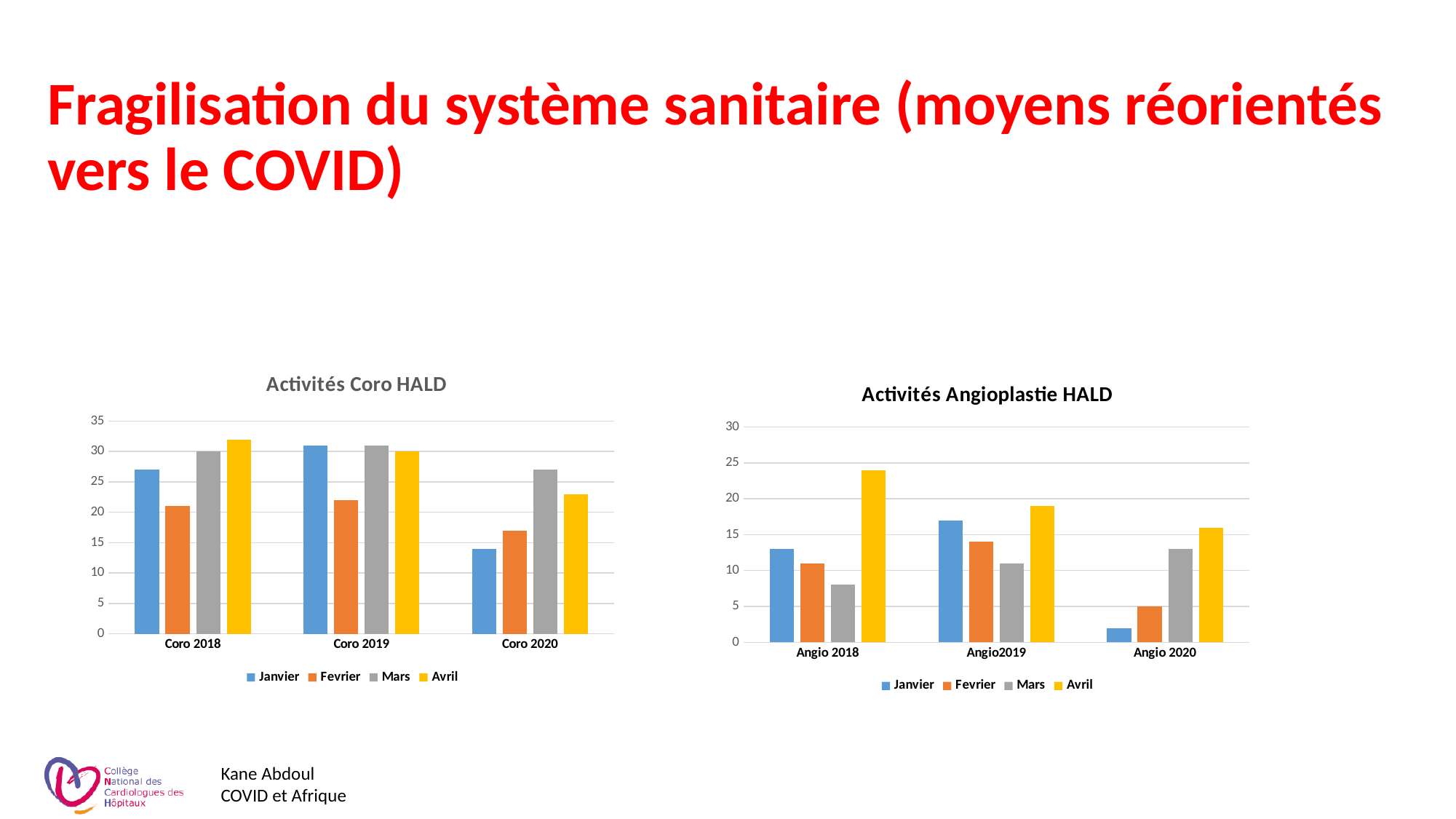
In 'Activités Coro HALD', what is the value for Avril in Coro 2019? 30 In 'Activités Angioplastie HALD', which bar is the highest in the whole chart? Avril, Angio 2018 In 'Activités Angioplastie HALD', which bar is the lowest in the whole chart? Janvier, Angio 2020 In 'Activités Angioplastie HALD', what is the value for Fevrier in Angio 2020? 5 What type of chart is 'Activités Coro HALD'? bar chart In 'Activités Coro HALD', is the value for Janvier in Coro 2020 greater or less than 15? less In 'Activités Angioplastie HALD', does the Avril series rise or fall from Angio 2018 to Angio 2020? fall How many series does the legend of 'Activités Angioplastie HALD' list? 4 How many categories are shown on the x axis of 'Activités Coro HALD'? 3 In 'Activités Angioplastie HALD', is the value for Avril in Angio 2018 greater or less than 20? greater In 'Activités Coro HALD', what is the value for Mars in Coro 2018? 30 In 'Activités Coro HALD', which is larger for Coro 2020: Fevrier or Mars? Mars